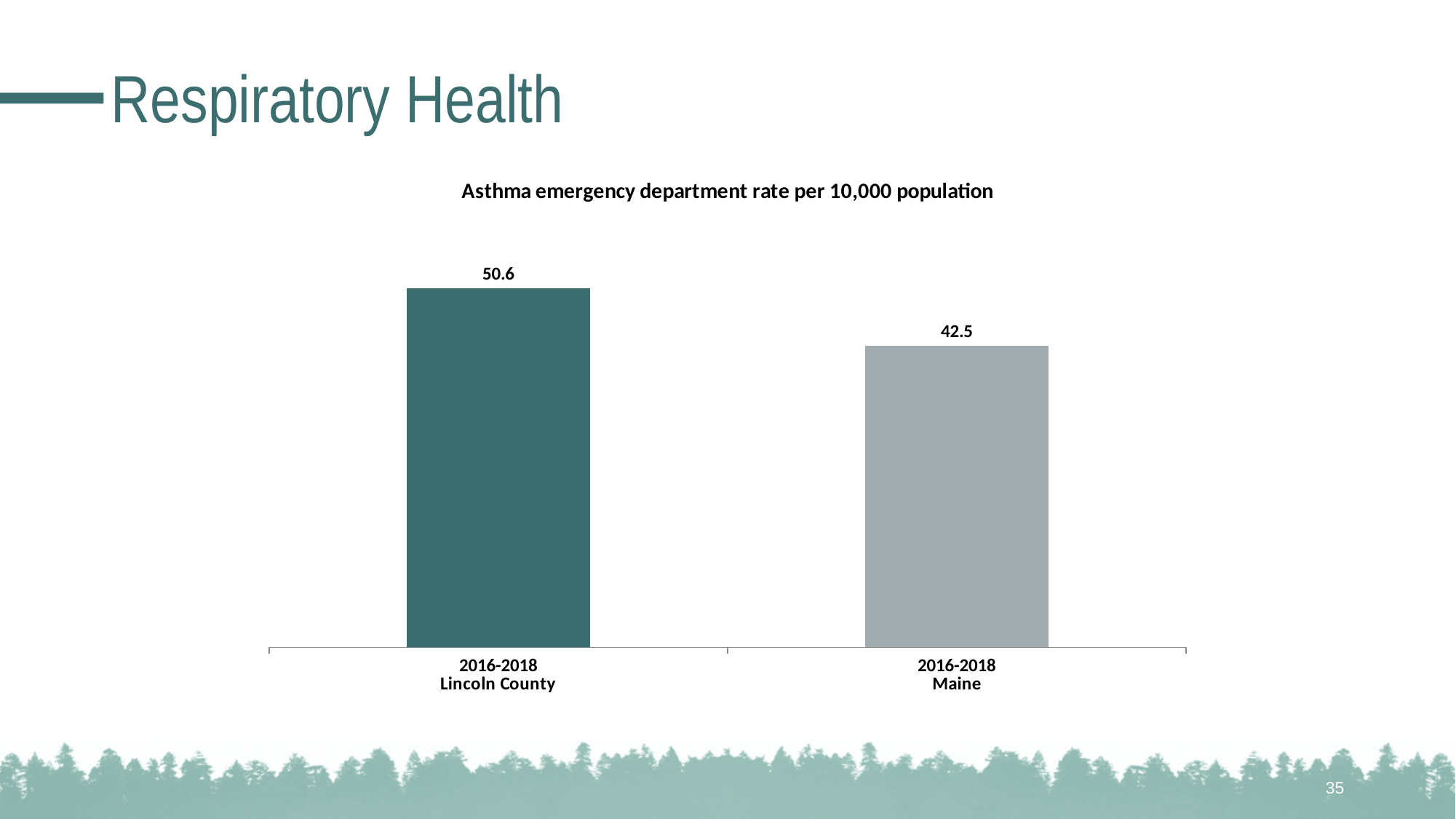
Is the asthma emergency department rate for Maine larger or smaller than the rate for Lincoln County? smaller Which category has the lower asthma emergency department rate? Maine What is the title of the chart? Asthma emergency department rate per 10,000 population What time period do both bars in the chart cover? 2016-2018 How many bars are shown in the chart? 2 What is the asthma emergency department rate per 10,000 population for Lincoln County in 2016-2018? 50.6 What is the difference between the Lincoln County and Maine asthma emergency department rates? 8.1 What kind of chart is shown on the slide? bar chart What is the asthma emergency department rate per 10,000 population for Maine in 2016-2018? 42.5 Which category has the higher asthma emergency department rate, Lincoln County or Maine? Lincoln County